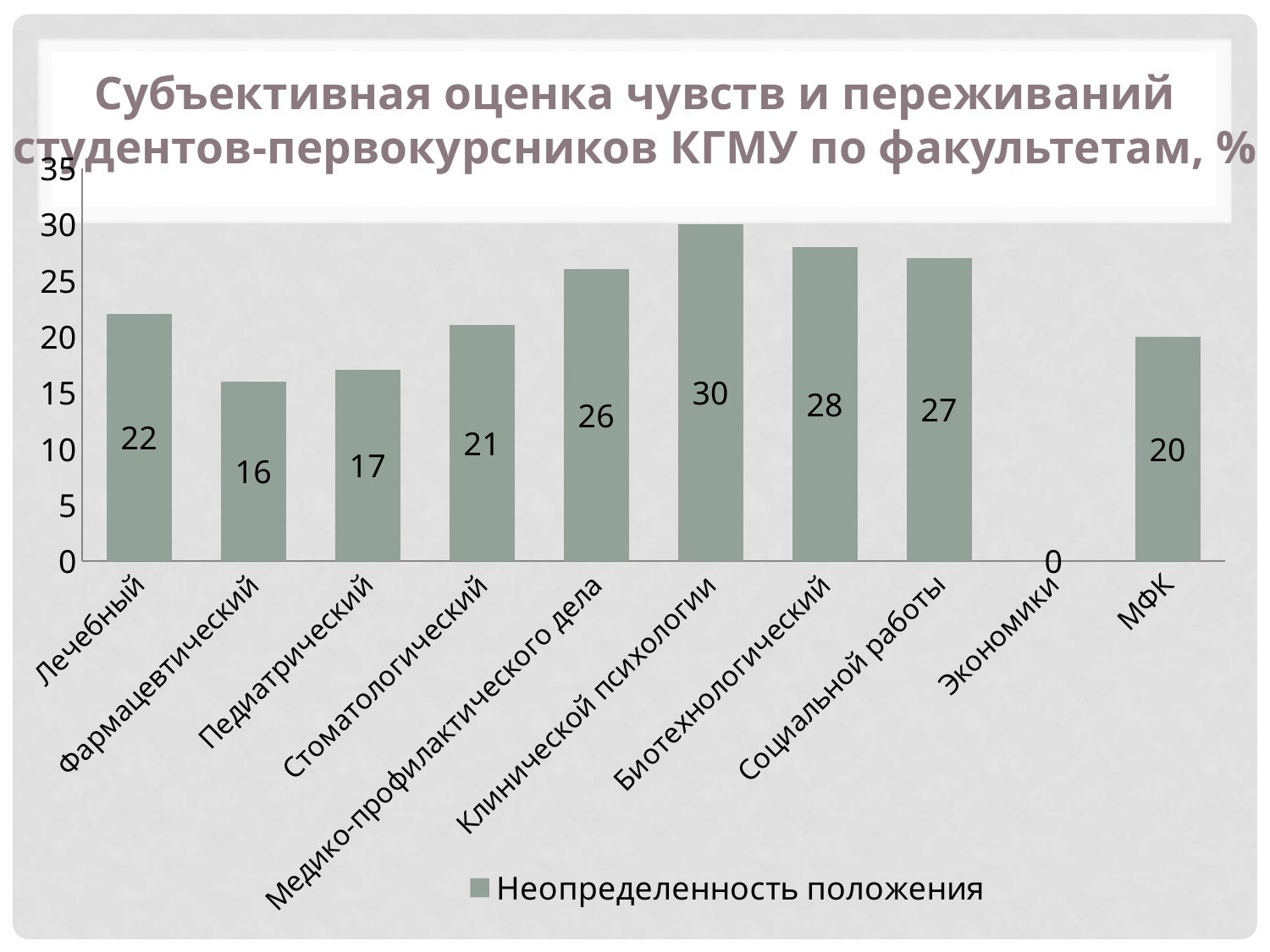
Which is larger, the value for Стоматологический or the value for Педиатрический? Стоматологический What kind of chart is this? bar chart How many series does the legend list? 1 What is the value for Лечебный? 22 Which faculty has the lowest value? Экономики What is the legend entry for the series? Неопределенность положения What is the value for Клинической психологии? 30 Which faculty has the highest value? Клинической психологии How many faculties are shown on the x axis? 10 Is the value for Социальной работы greater or less than 25? greater What is the value for Экономики? 0 What is the difference between the values for Биотехнологический and Фармацевтический? 12